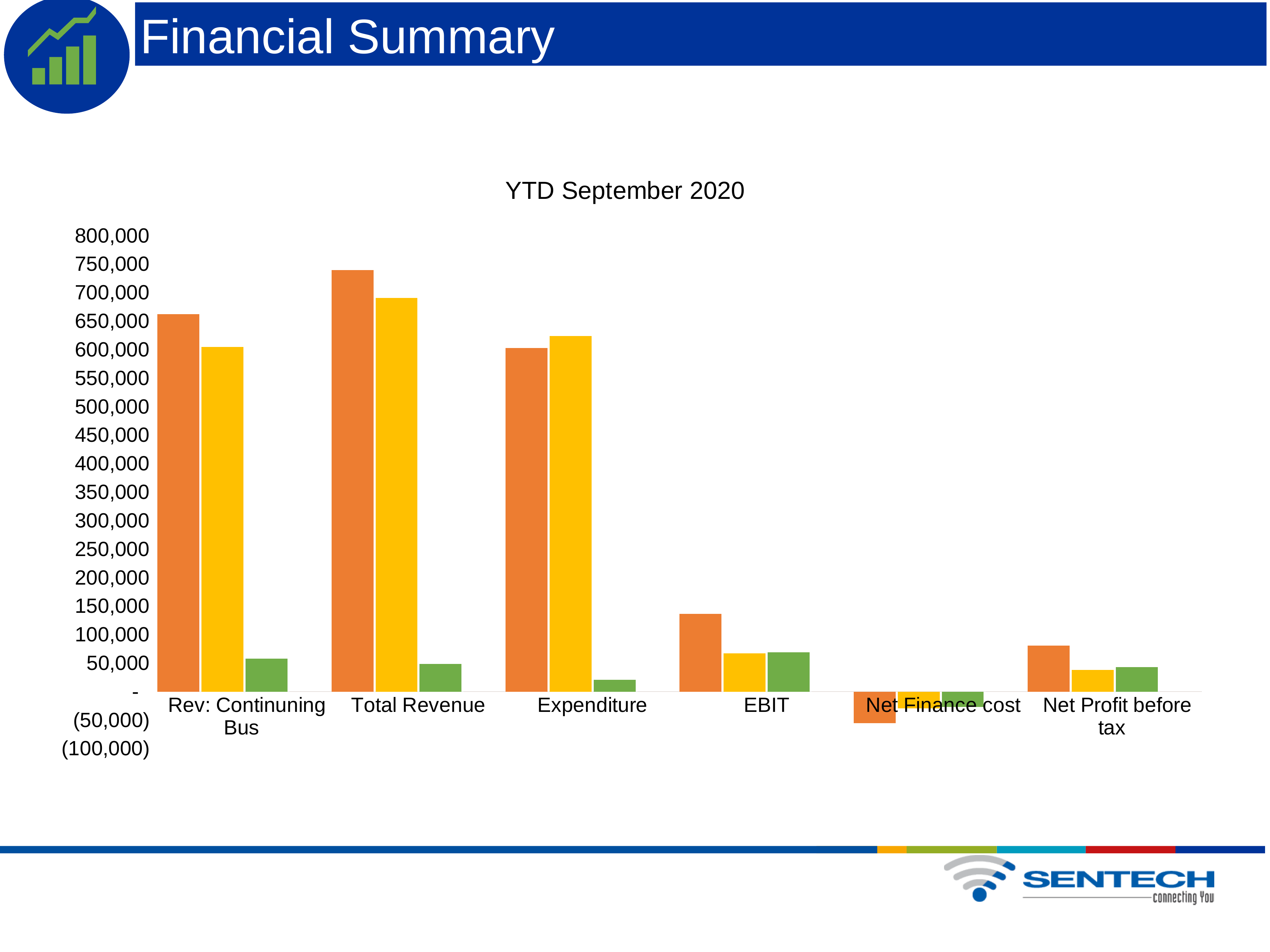
For Total Revenue, which is larger: the orange bar or the yellow bar? the orange bar For Rev: Continuning Bus, which is larger: the orange bar or the green bar? the orange bar Is the green bar for Expenditure greater or less than 50,000? less What is the title of the chart? YTD September 2020 What kind of chart is shown on the slide? bar chart Which category has the tallest orange bar? Total Revenue Is the orange bar for EBIT greater or less than 100,000? greater How many bars are plotted for each category in the chart? 3 How many categories are shown on the x axis of the chart? 6 Which category has the lowest orange bar? Net Finance cost Is the yellow bar for Expenditure greater or less than 600,000? greater